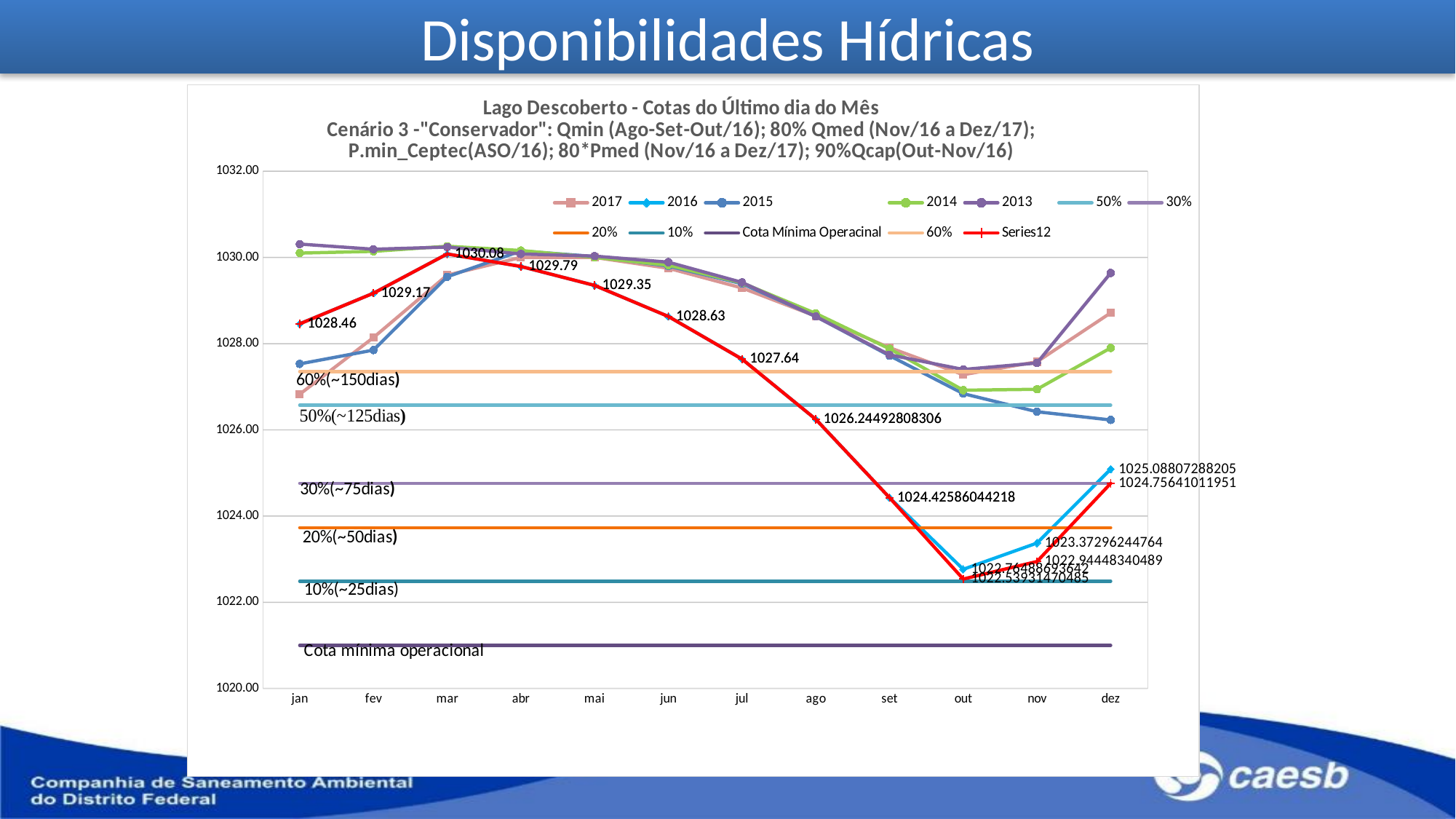
What is the difference between the Series12 values in mar and jan? 1.62 In dez, which is larger: the 2016 series or Series12? 2016 How many series does the legend list? 12 In which month does Series12 reach its lowest value? out In which month does Series12 reach its highest value? mar What is the value of Series12 in mar? 1030.08 How many months are shown along the x axis? 12 What is the value of Series12 in jan? 1028.46 Is the value for the 2013 series in dez greater or less than 1028.00? greater What kind of chart is shown on the slide? line chart What is the value of the 2016 series in dez? 1025.08807288205 Does Series12 rise or fall from mar to out? fall